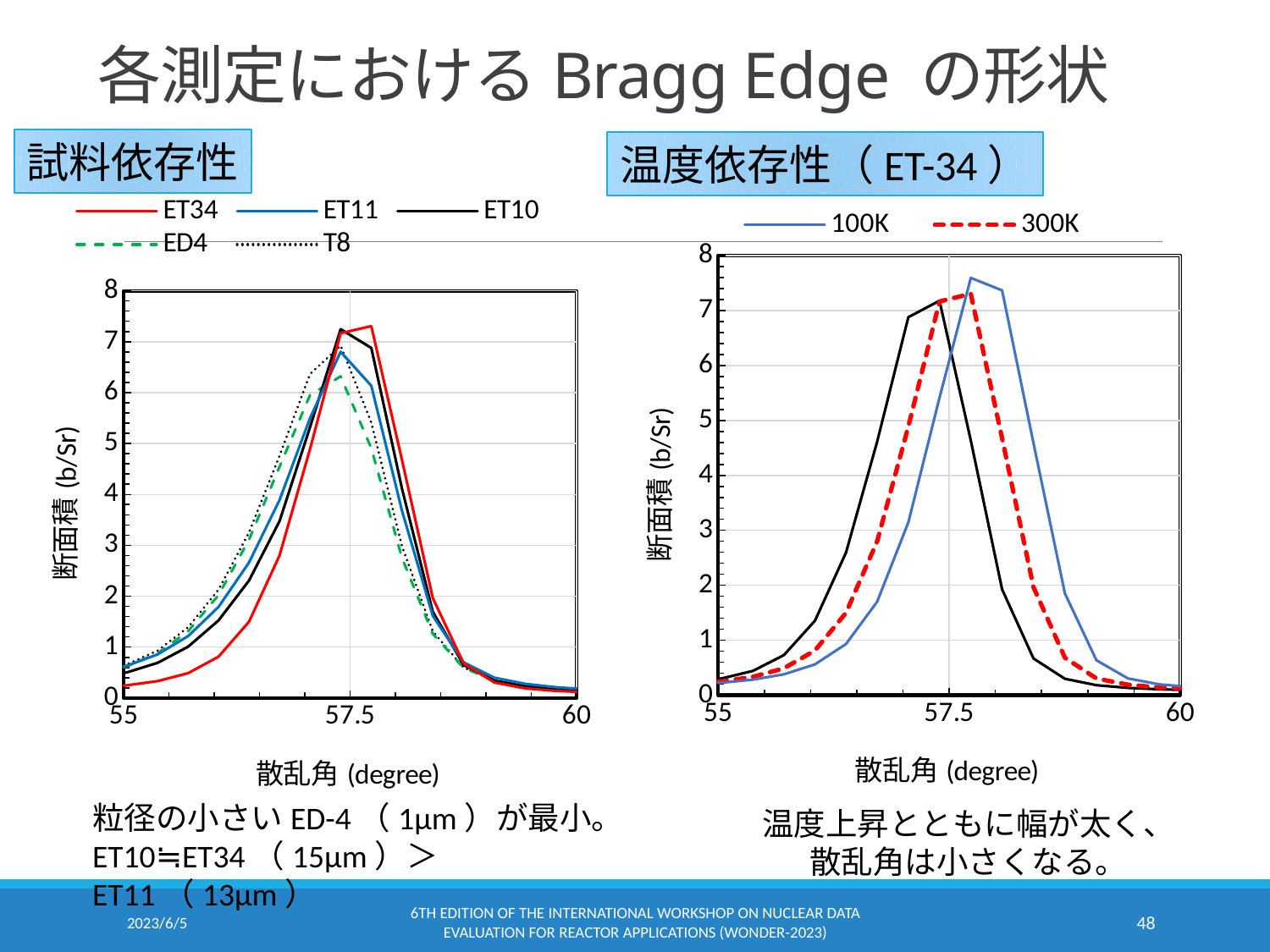
What kind of chart is the left chart (試料依存性)? line chart What is the x-axis title of the left chart (試料依存性)? 散乱角 (degree) In the left chart (試料依存性), is the peak value of ED4 greater or less than 7? less In the right chart (温度依存性 (ET-34)), does the 100K series rise or fall between 58 and 60 degrees? fall How many series does the legend of the left chart (試料依存性) list? 5 In the right chart (温度依存性 (ET-34)), which series has the higher peak, 100K or 300K? 100K In the left chart (試料依存性), which series has the lowest peak? ED4 In the right chart (温度依存性 (ET-34)), is the peak value of 100K greater or less than 7? greater How many series does the legend of the right chart (温度依存性 (ET-34)) list? 2 In the left chart (試料依存性), is the peak value of ET34 greater or less than 7? greater What are the legend entries of the right chart (温度依存性 (ET-34))? 100K, 300K